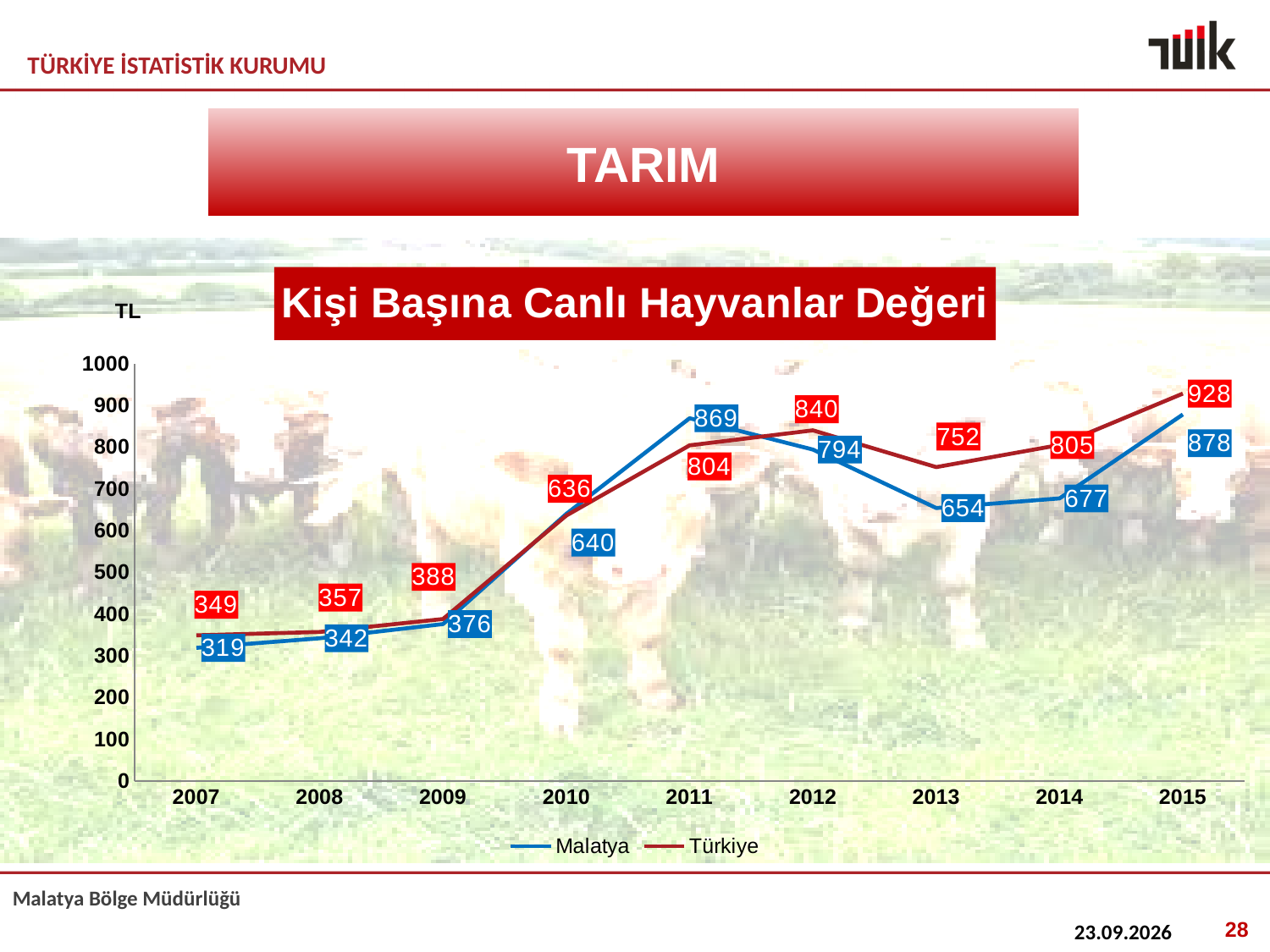
How many years are shown on the x axis? 9 Which series has the larger value in 2011, Malatya or Türkiye? Malatya Which series has the larger value in 2012, Malatya or Türkiye? Türkiye How many series does the legend list? 2 What is the value for Malatya in 2011? 869 What is the title of the chart? Kişi Başına Canlı Hayvanlar Değeri In which year is the Malatya series lowest? 2007 What is the value for Malatya in 2007? 319 In which year is the Türkiye series highest? 2015 What kind of chart is shown? line chart What is the difference between the Türkiye and Malatya values in 2013? 98 What is the value for Türkiye in 2015? 928